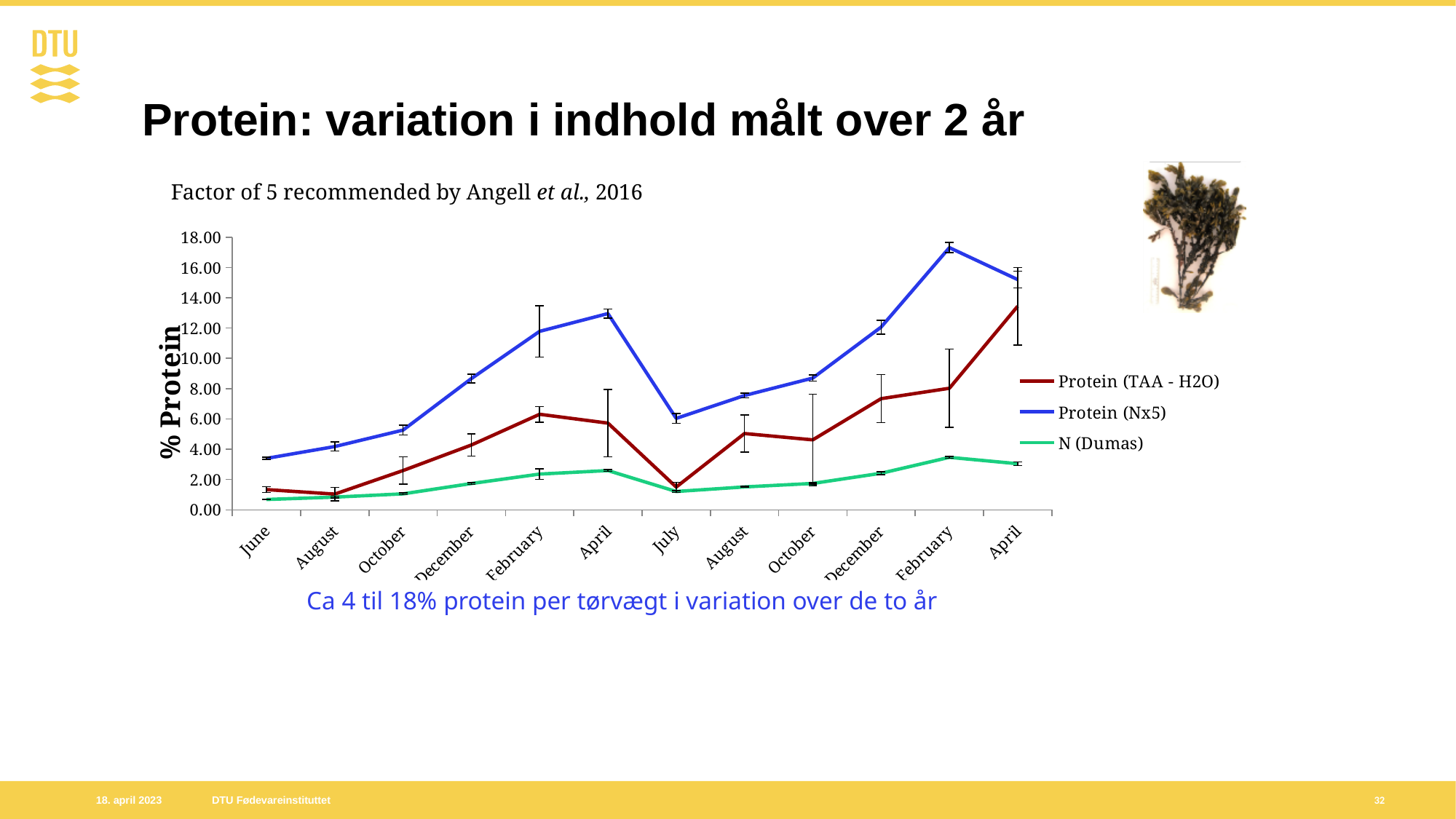
How many series does the chart legend list? 3 How many points are plotted along the x axis for each series? 12 Is the value of Protein (TAA - H2O) at the second April greater or less than 12.00? greater What kind of chart is shown on the slide? line chart At the second February, which series has the larger value: Protein (TAA - H2O) or N (Dumas)? Protein (TAA - H2O) Is the value of Protein (Nx5) at July greater or less than 8.00? less Is the value of Protein (Nx5) at June greater or less than 4.00? less At which x-axis position does the Protein (Nx5) series reach its highest value? the second February At which x-axis position does the Protein (TAA - H2O) series reach its highest value? the second April At which x-axis position is the Protein (Nx5) series at its lowest value? June What is the title of the y axis? % Protein Does the Protein (Nx5) series rise or fall from June to the first April? rise